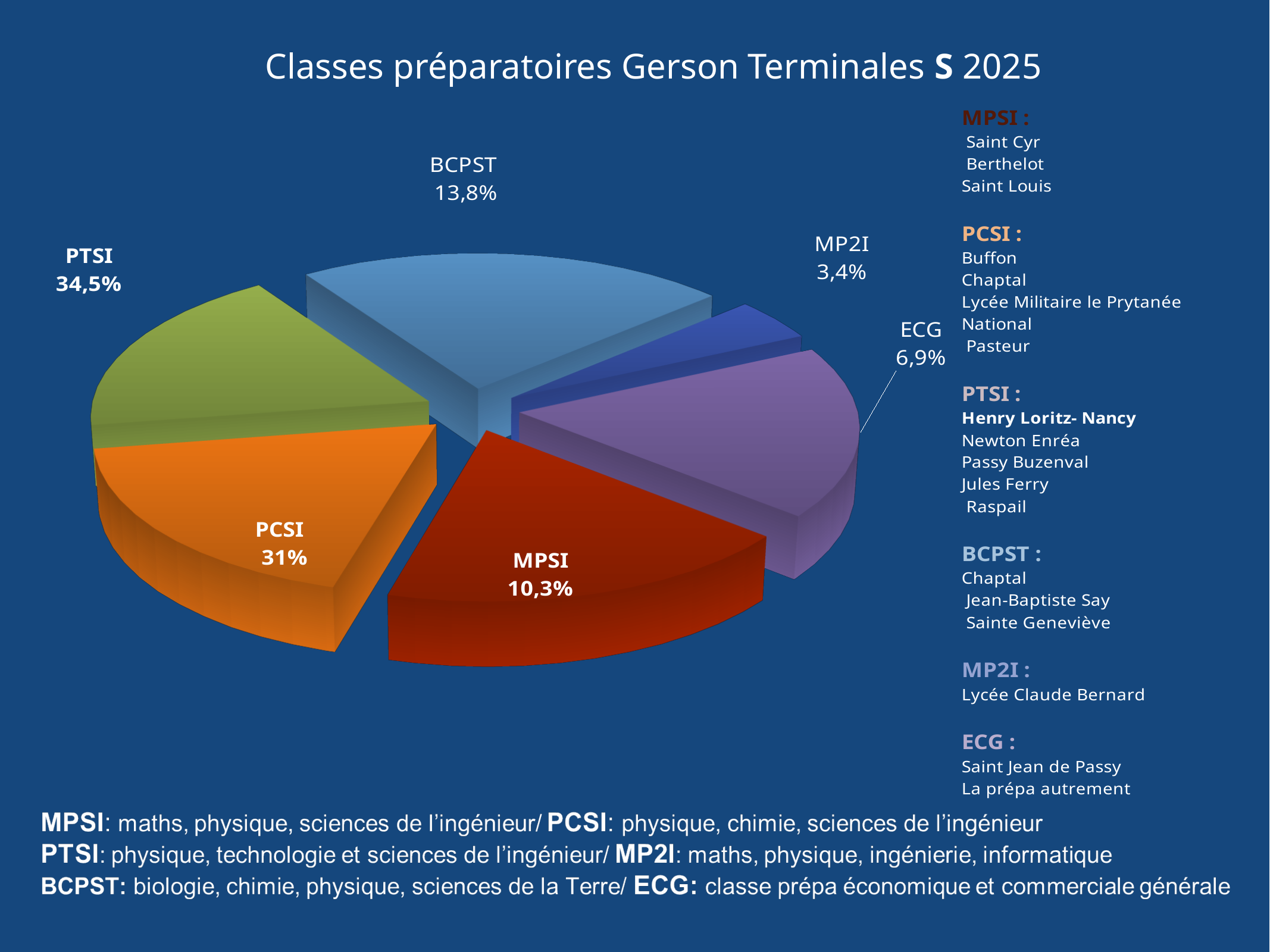
What percentage is shown for BCPST? 13,8% What share of the pie does PTSI represent? 34,5% Which category has the smallest share of the pie? MP2I What percentage is shown for MP2I? 3,4% Which is larger, the share for BCPST or the share for MPSI? BCPST What colour is the MPSI slice of the pie? red What is the title of the chart? Classes préparatoires Gerson Terminales S 2025 How many slices does the pie chart have? 6 What percentage is shown for PCSI? 31% What kind of chart is shown on the slide? pie chart What is the difference between the PTSI and PCSI percentages? 3,5%